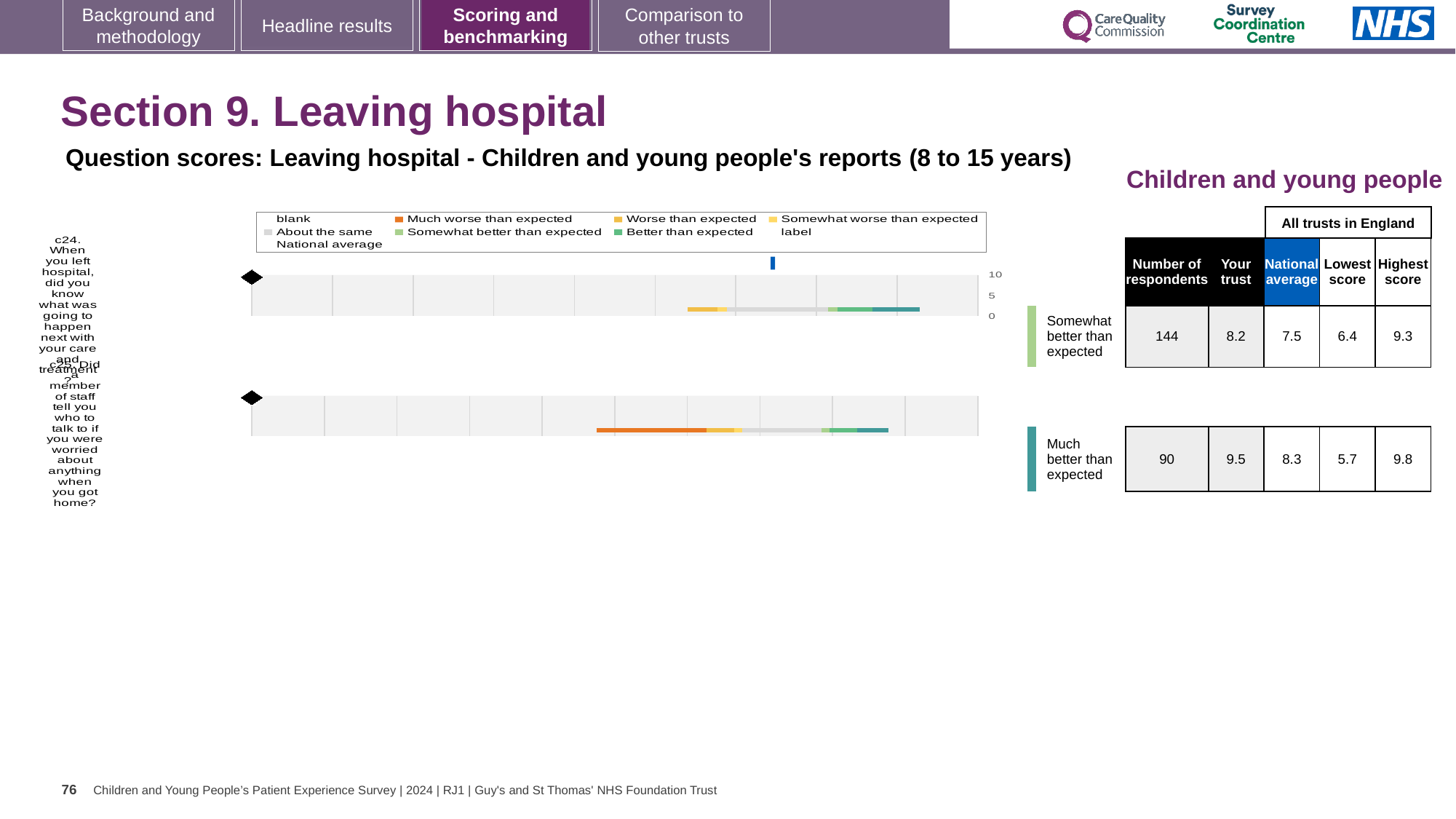
How many respondents answered question c24? 144 What is the difference between the 'Your trust' score and the national average for question c25? 1.2 What is the difference between the highest and lowest trust scores for question c24? 2.9 What benchmark category is the trust's score for question c25 placed in? Much better than expected Which question has the higher 'Your trust' score, c24 or c25? c25 Which question has the larger number of respondents, c24 or c25? c24 How many questions (bars) are plotted in the chart? 2 What is the highest value shown on the chart's score axis? 10 What is the lowest score across all trusts in England for question c25? 5.7 According to the table, what is the 'Your trust' score for question c24 (did you know what was going to happen next with your care and treatment)? 8.2 What kind of chart is used to show the question scores for c24 and c25? Bar chart According to the table, what is the national average score for question c25 (did a member of staff tell you who to talk to if you were worried when you got home)? 8.3